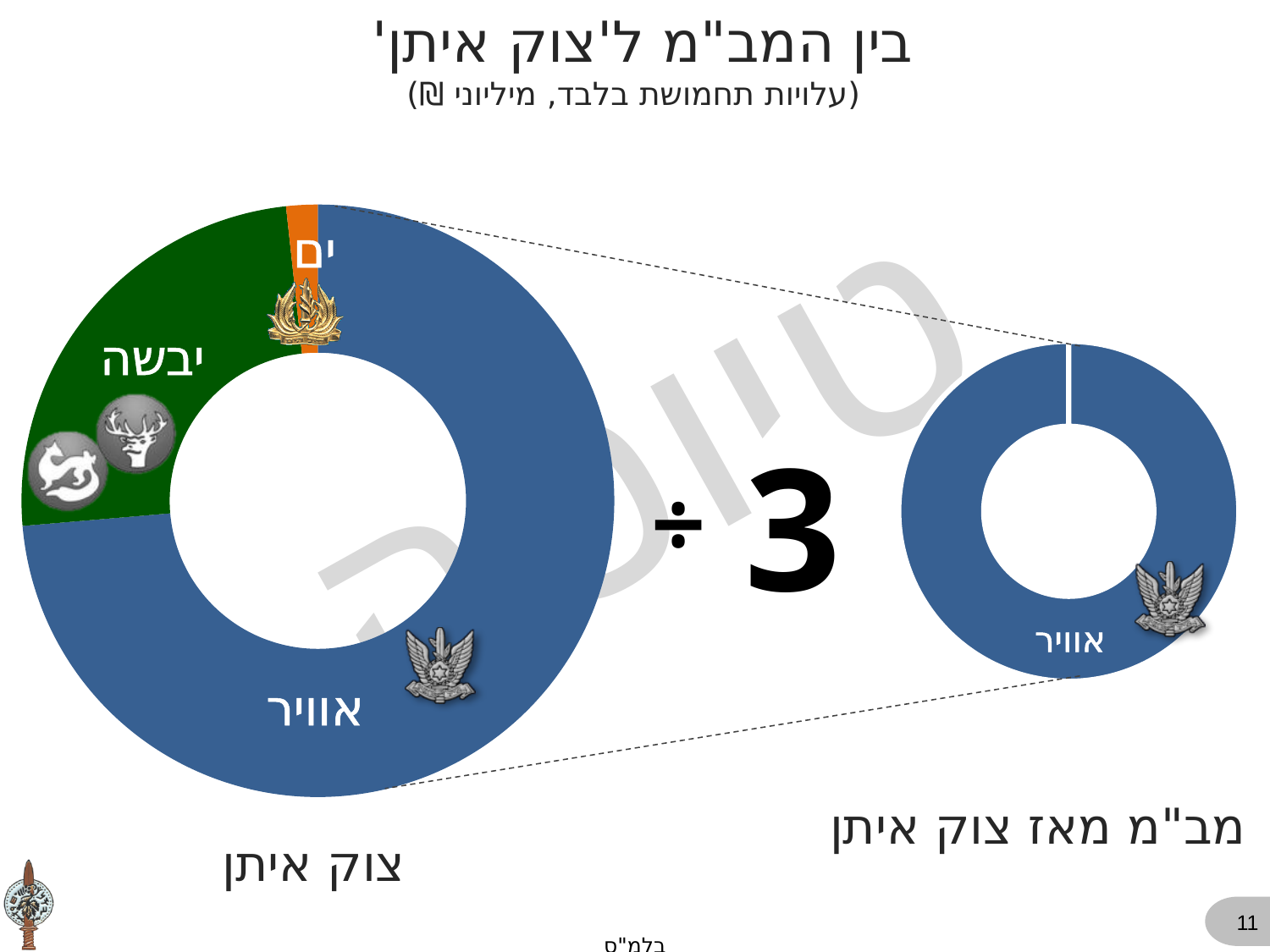
What kind of chart is the right chart titled 'מב"מ מאז צוק איתן'? Doughnut (pie) chart What is the title of the slide containing the two charts? בין המב"מ ל'צוק איתן' What kind of chart is the left chart titled 'צוק איתן'? Doughnut (pie) chart In the left chart 'צוק איתן', which category has the largest share? אוויר In the left chart 'צוק איתן', which is larger: the share for יבשה or the share for ים? יבשה Which category is shown in the right chart 'מב"מ מאז צוק איתן'? אוויר In the left chart 'צוק איתן', which is larger: the share for אוויר or the share for יבשה? אוויר In the left chart 'צוק איתן', what colour is the segment for יבשה? Green How many segments does the left chart 'צוק איתן' have? 3 In the left chart 'צוק איתן', which category has the smallest share? ים